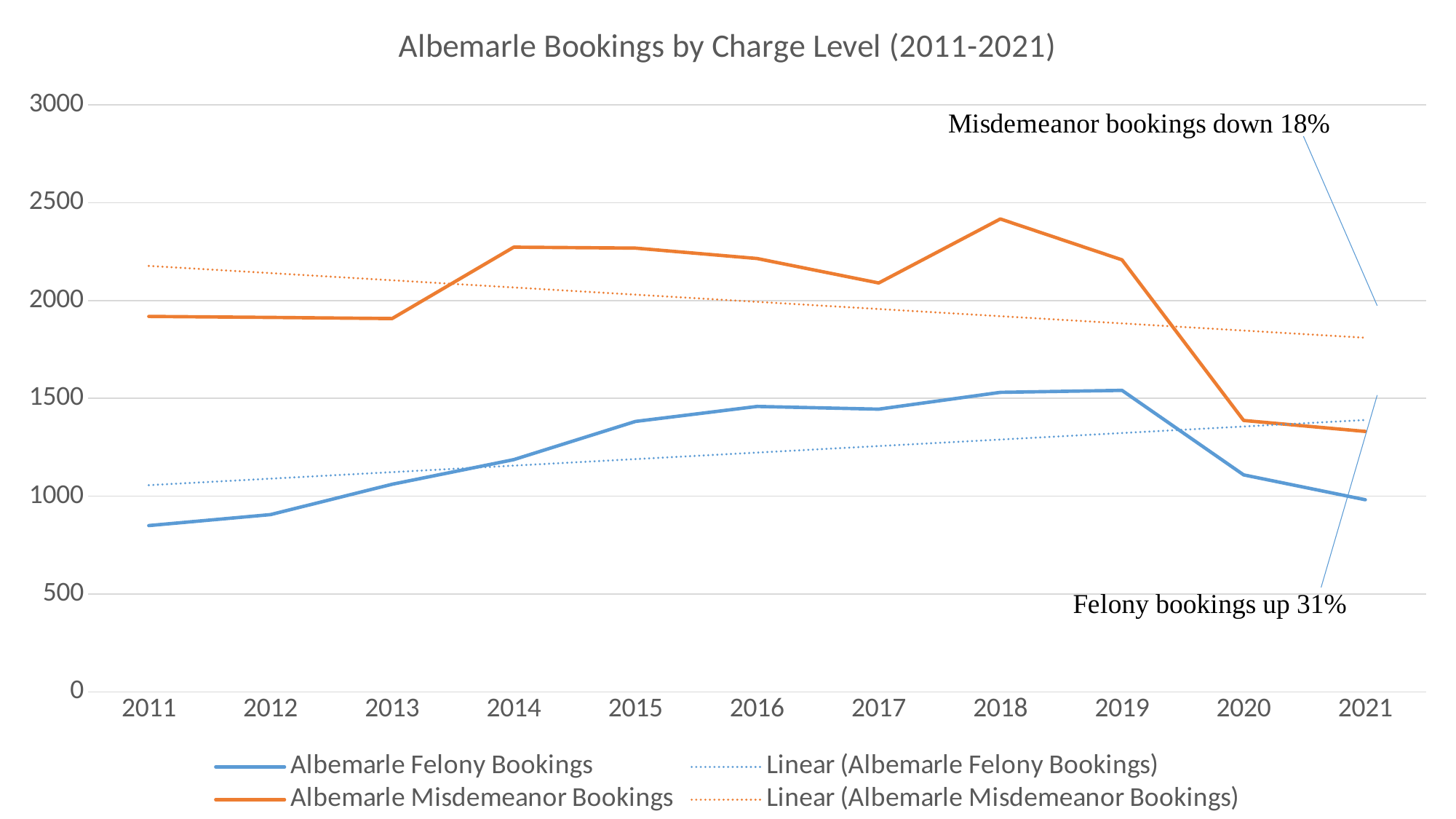
Did Albemarle Felony Bookings rise or fall from 2011 to 2019? rise Did Albemarle Misdemeanor Bookings rise or fall from 2019 to 2021? fall Is the value for Albemarle Felony Bookings in 2011 greater or less than 1000? less In which year were Albemarle Misdemeanor Bookings highest? 2018 What is the title of the chart? Albemarle Bookings by Charge Level (2011-2021) Is the value for Albemarle Misdemeanor Bookings in 2020 greater or less than 1500? less Is the value for Albemarle Misdemeanor Bookings in 2018 greater or less than 2000? greater What kind of chart is shown on the slide? line chart According to the annotation on the chart, by what percentage are felony bookings up? 31% How many entries does the legend list? 4 How many years are plotted along the x axis? 11 Which series had the larger value in 2015, Albemarle Felony Bookings or Albemarle Misdemeanor Bookings? Albemarle Misdemeanor Bookings